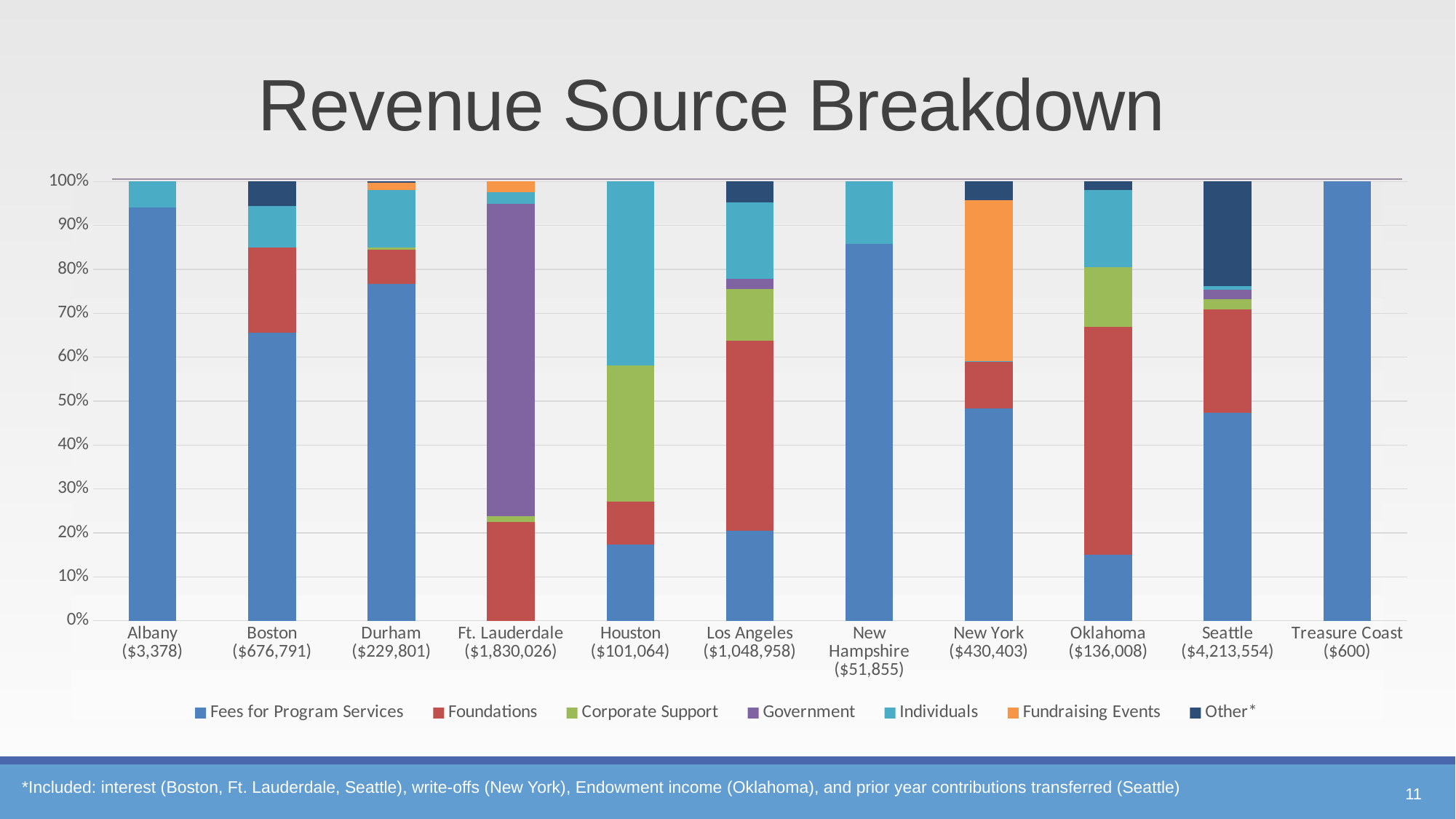
How many revenue source series does the legend list? 7 Which city has the largest total revenue amount shown in its axis label? Seattle How many cities (categories) are shown along the x axis? 11 What total revenue amount is shown in the axis label for Treasure Coast? $600 Which series is shown in orange in the legend? Fundraising Events Is the Fees for Program Services share for Oklahoma greater or less than 20%? less What total revenue amount is shown in the axis label for Seattle? $4,213,554 What is the difference between the total revenue amounts shown for Boston and Durham? $446,990 Is the Government share for Ft. Lauderdale greater or less than 60%? greater Is the Fees for Program Services share for Albany greater or less than 90%? greater Which city has the smallest total revenue amount shown in its axis label? Treasure Coast What kind of chart is shown on the slide? Stacked bar chart